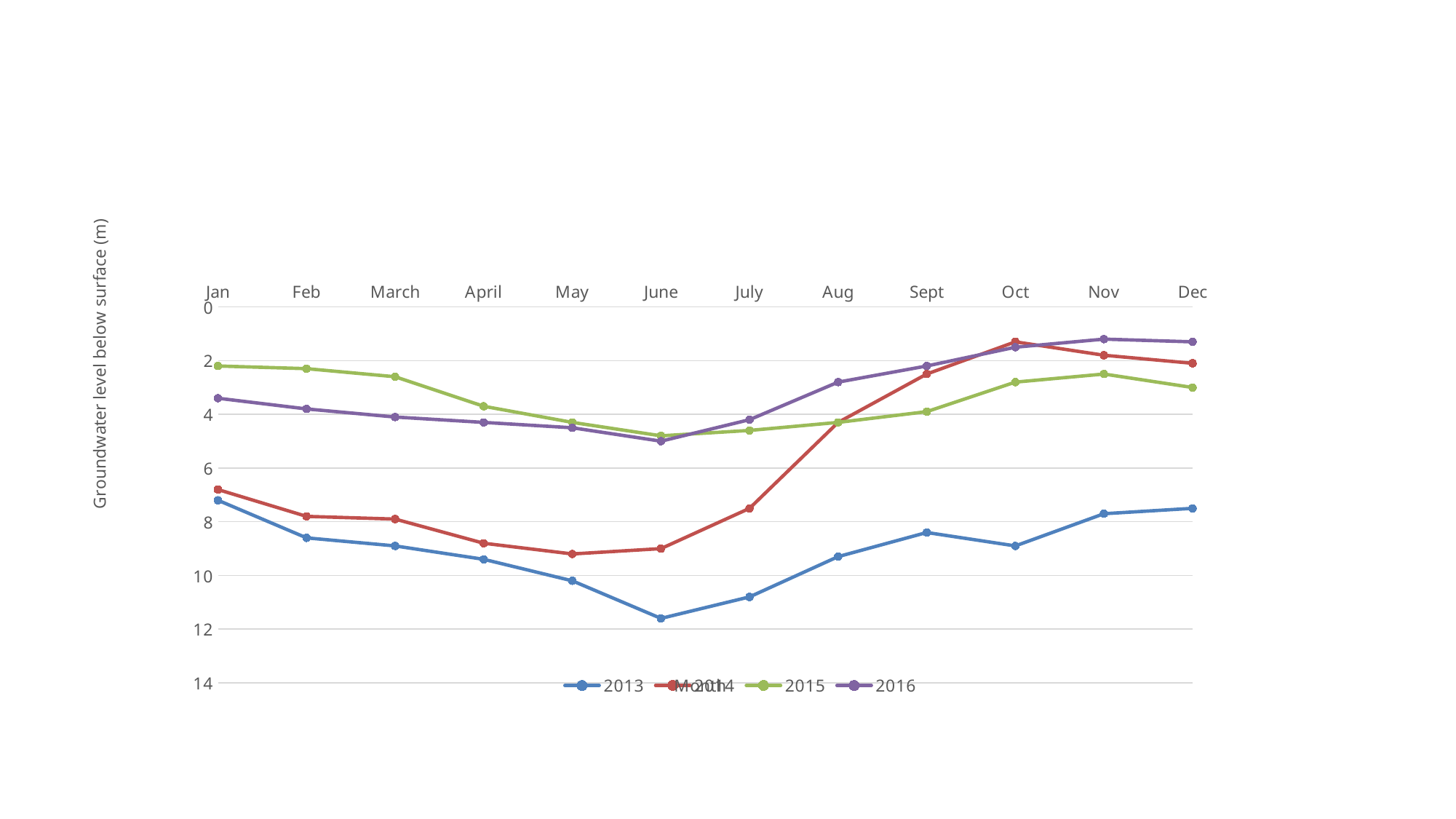
Is the value for 2016 in June greater or less than 4? greater Is the value for 2013 in June greater or less than 10? greater In which month does the 2013 series reach its highest value? June Do the values for 2014 rise or fall from June to Oct? fall In Jan, which series has the larger value, 2013 or 2015? 2013 How many series does the legend list? 4 Is the value for 2014 in Oct greater or less than 2? less What kind of chart is shown on the slide? line chart What is the title of the y axis? Groundwater level below surface (m) How many months are shown along the x axis? 12